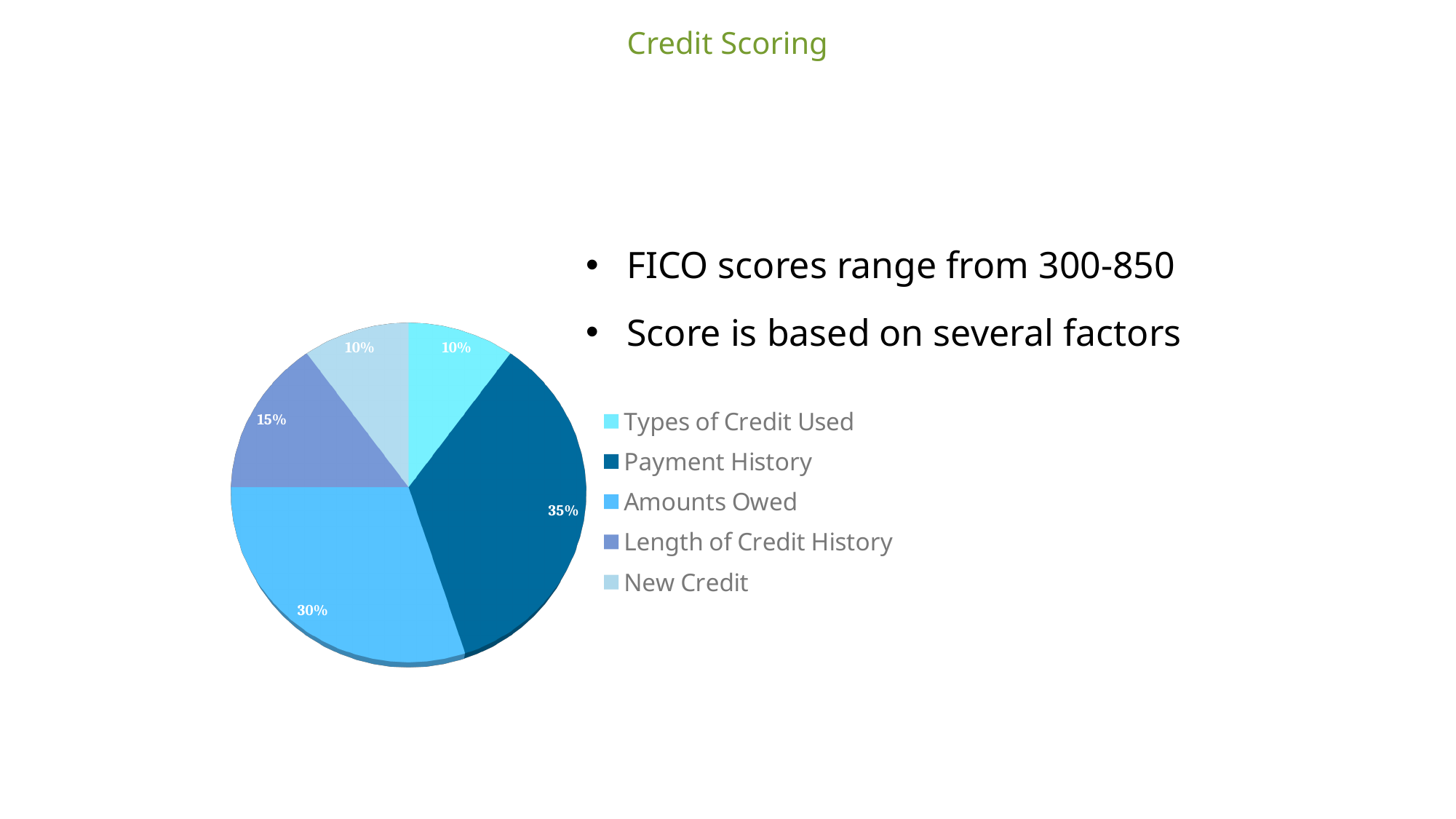
What type of chart is shown on the slide? pie chart What share of the pie does Length of Credit History represent? 15% Which factor has the largest slice of the pie? Payment History What share of the pie does New Credit represent? 10% How many slices does the pie chart have? 5 What share of the pie does Amounts Owed represent? 30% How many entries does the legend list? 5 What is the difference in percentage points between Payment History and Amounts Owed? 5 Which legend entry is shown in the darkest blue colour? Payment History What is the difference in percentage points between Amounts Owed and Length of Credit History? 15 Which is larger, Length of Credit History or Types of Credit Used? Length of Credit History